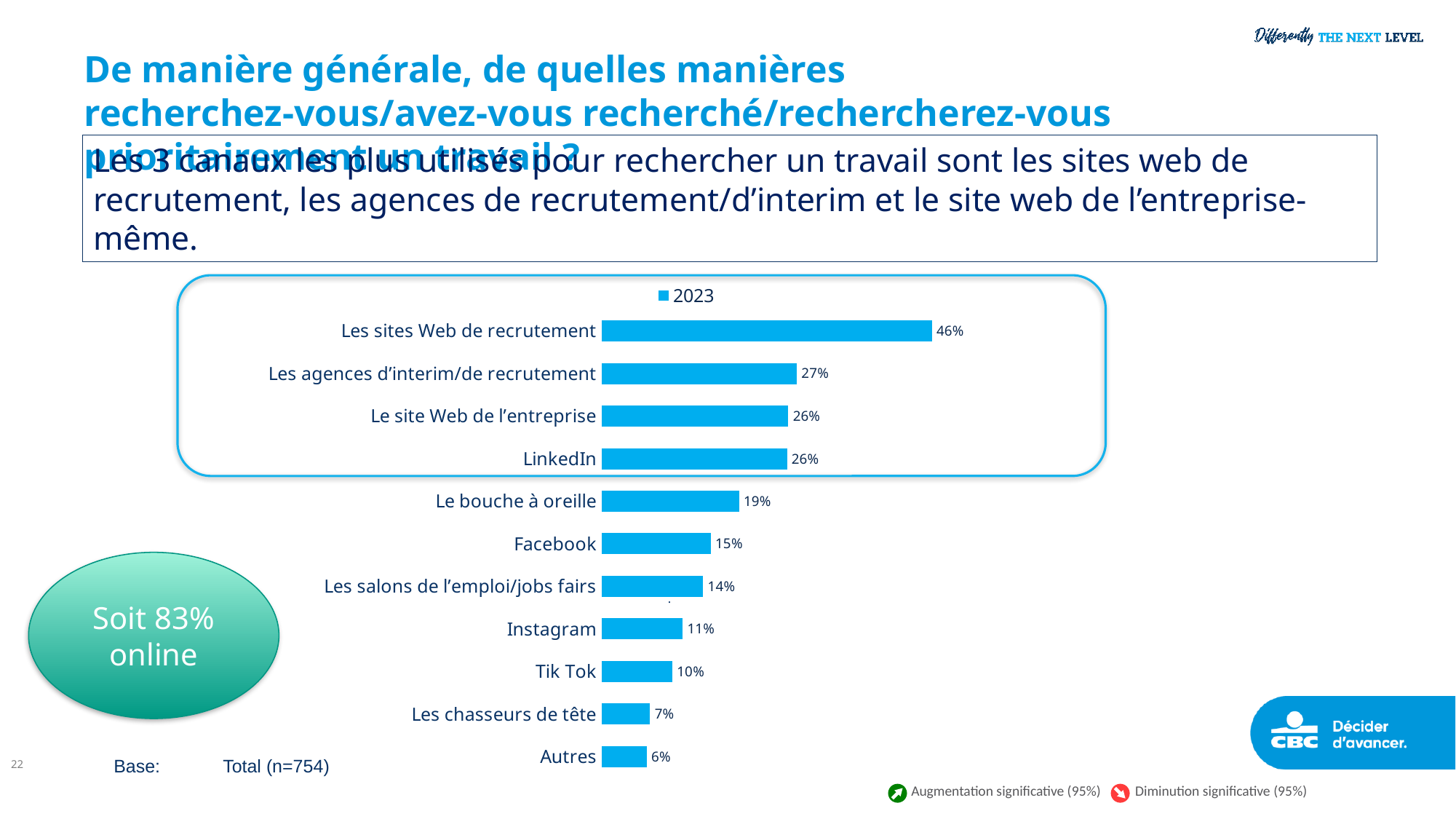
What is the difference between Le bouche à oreille and Instagram? 8% What is the value for Les sites Web de recrutement? 46% How many series does the legend list? 1 Which category has the highest value? Les sites Web de recrutement What is the value for Tik Tok? 10% What kind of chart is shown? Bar chart What is the value for Facebook? 15% Which category has the lowest value? Autres Which is larger, Facebook or Les salons de l'emploi/jobs fairs? Facebook How many categories are shown in the chart? 11 What is the difference between Les sites Web de recrutement and Les agences d'interim/de recrutement? 19% What is the legend entry of the chart? 2023